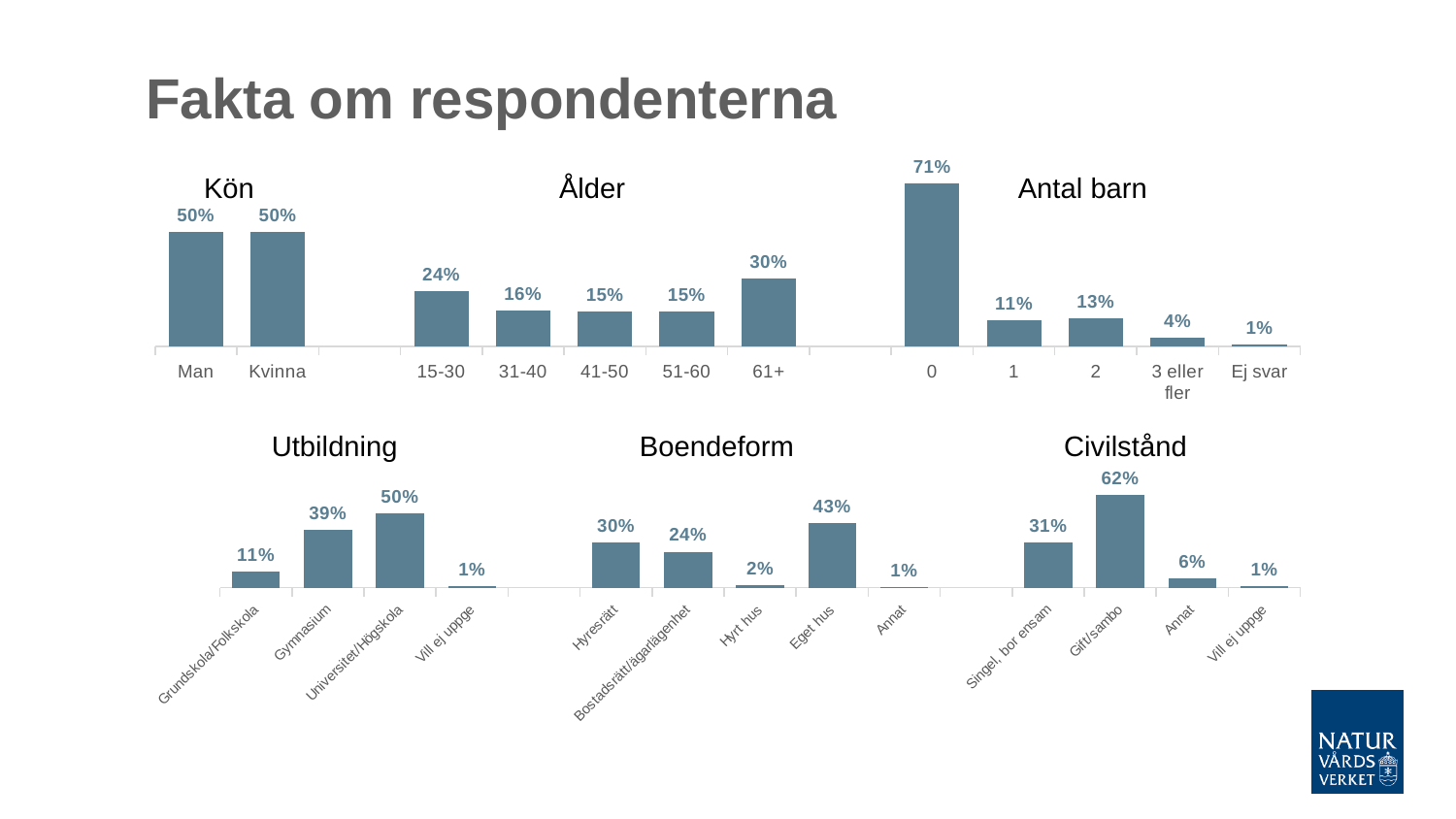
In the Kön chart, what is the value for Kvinna? 50% In the Boendeform chart, what is the difference between Hyresrätt and Bostadsrätt/ägarlägenhet? 6% In the Boendeform chart, what is the value for Eget hus? 43% In the Ålder chart, which age group has the highest value? 61+ In the Ålder chart, what is the difference between the values for 61+ and 15-30? 6% In the Utbildning chart, what is the value for Gymnasium? 39% In the Antal barn chart, how many categories are shown? 5 In the Civilstånd chart, which category has the highest value? Gift/sambo In the Utbildning chart, which is larger, Universitet/Högskola or Grundskola/Folkskola? Universitet/Högskola In the Antal barn chart, which category has the lowest value? Ej svar What type of chart is the Civilstånd chart? Bar chart In the Antal barn chart, what is the value for 0? 71%